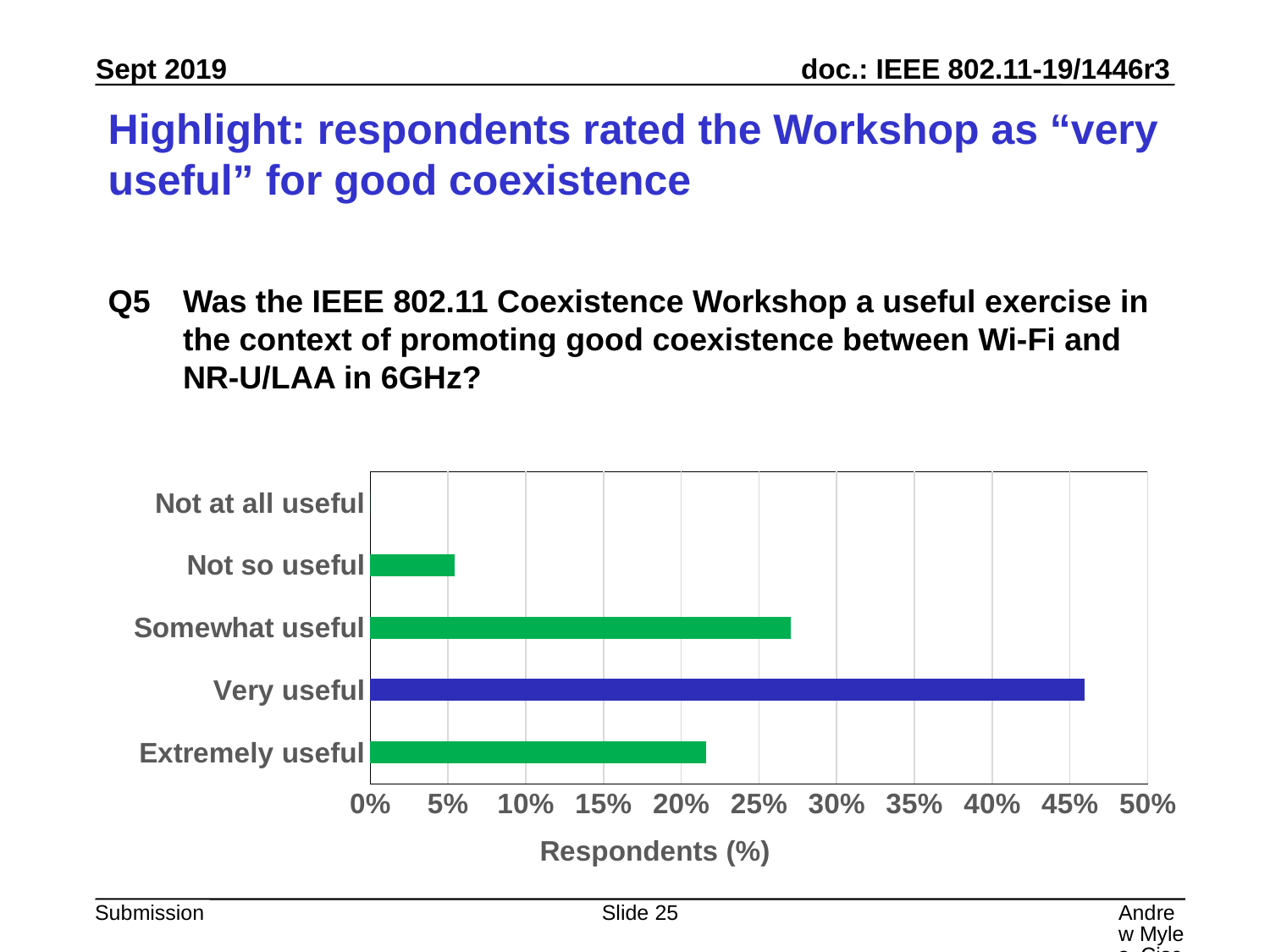
What kind of chart is shown on the slide? bar chart Is the value for Somewhat useful greater or less than 25%? greater Which category has the lowest value? Not at all useful Which is larger, the value for Very useful or the value for Somewhat useful? Very useful Is the value for Very useful greater or less than 40%? greater Is the value for Extremely useful greater or less than 25%? less How many categories are shown on the chart? 5 Which is larger, the value for Somewhat useful or the value for Extremely useful? Somewhat useful Which category's bar is coloured blue rather than green? Very useful What is the title of the horizontal axis? Respondents (%) Which category has the highest value? Very useful